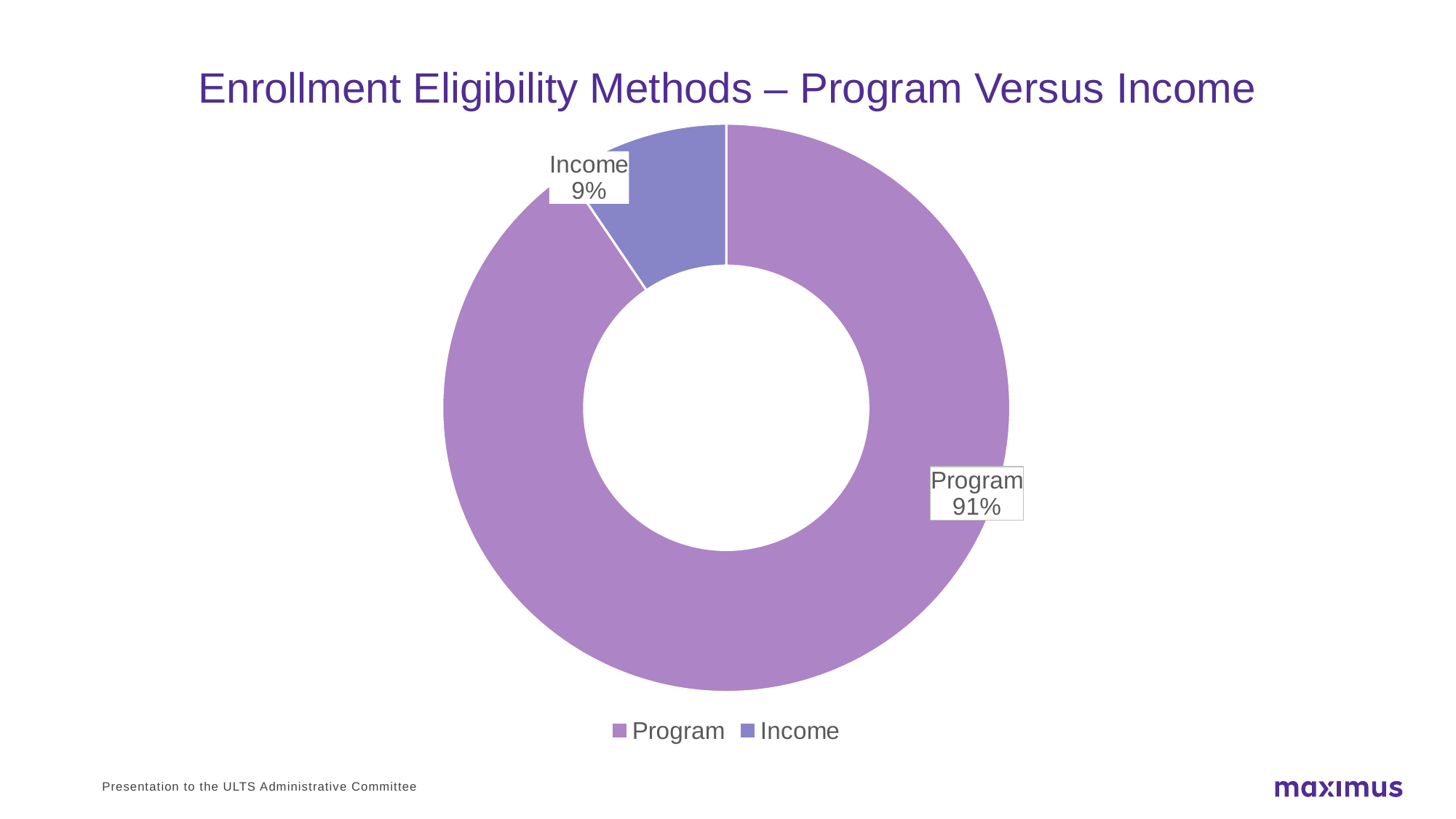
Which category has the largest share? Program Which category has the smallest share? Income How many categories are shown in the chart? 2 What kind of chart is shown on the slide? Doughnut (pie) chart Which category is shown in the blue-purple colour? Income What share of the chart does Income account for? 9% What is the difference in percentage points between the Program and Income shares? 82 What share of the chart does Program account for? 91% What is the title of the slide? Enrollment Eligibility Methods – Program Versus Income How many entries does the legend list? 2 Which is larger, the Program share or the Income share? Program